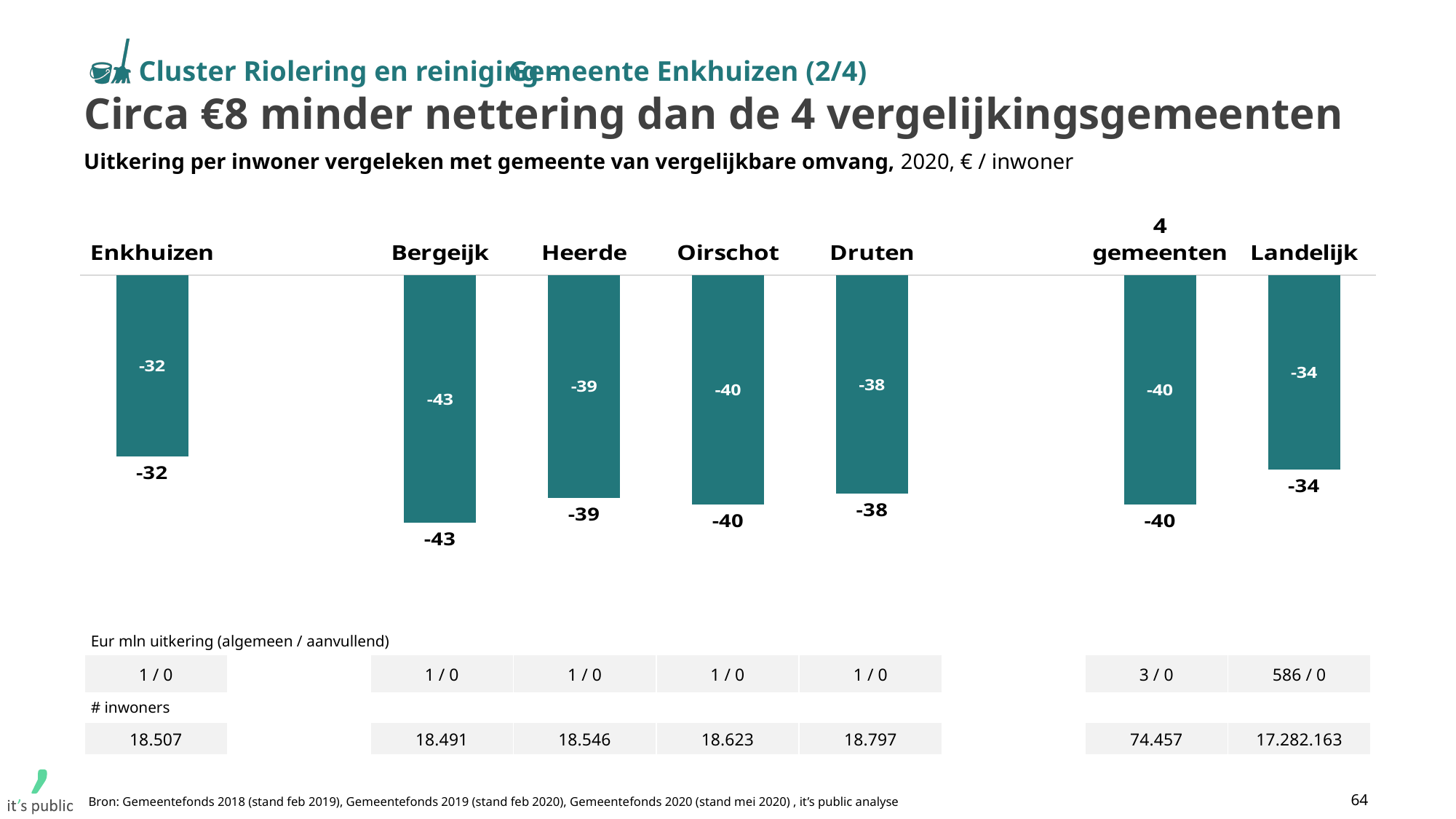
What kind of chart is shown on the slide? Bar chart What is the value for Bergeijk? -43 What is the value for Heerde? -39 What is the difference between the values for Enkhuizen and 4 gemeenten? 8 What unit is stated in the chart subtitle? € / inwoner Which has a larger (less negative) value, Druten or Oirschot? Druten What is the value for 4 gemeenten? -40 What is the value for Enkhuizen? -32 How many categories are shown in the chart? 7 Which category has the lowest (most negative) value? Bergeijk Which category has the highest (least negative) value? Enkhuizen What is the value for Landelijk? -34